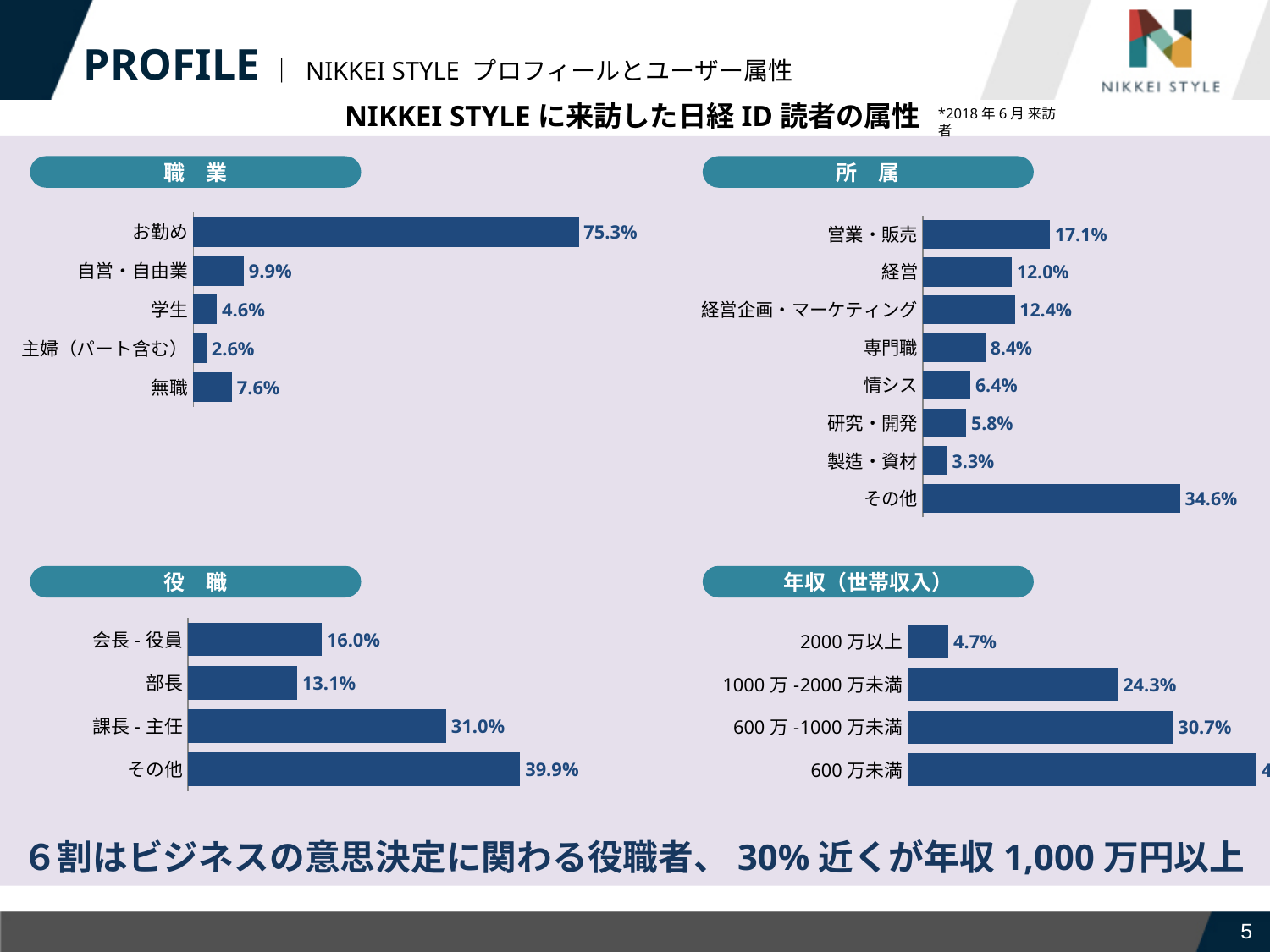
In the 役職 chart, what is the value for 課長 - 主任? 31.0% In the 所属 chart, how many categories are shown? 8 In the 所属 chart, which category has the highest value? その他 In the 職業 chart, which category has the lowest value? 主婦（パート含む） In the 年収（世帯収入） chart, which is larger, 2000 万以上 or 600 万 -1000 万未満? 600 万 -1000 万未満 What type of chart is the 職業 chart? Bar chart In the 所属 chart, what is the value for 営業・販売? 17.1% In the 年収（世帯収入） chart, what is the value for 1000 万 -2000 万未満? 24.3% In the 役職 chart, what is the difference between その他 and 会長 - 役員? 23.9% In the 所属 chart, which is larger, 経営 or 経営企画・マーケティング? 経営企画・マーケティング In the 職業 chart, what is the difference between 自営・自由業 and 無職? 2.3% In the 職業 chart, what is the value for お勤め? 75.3%